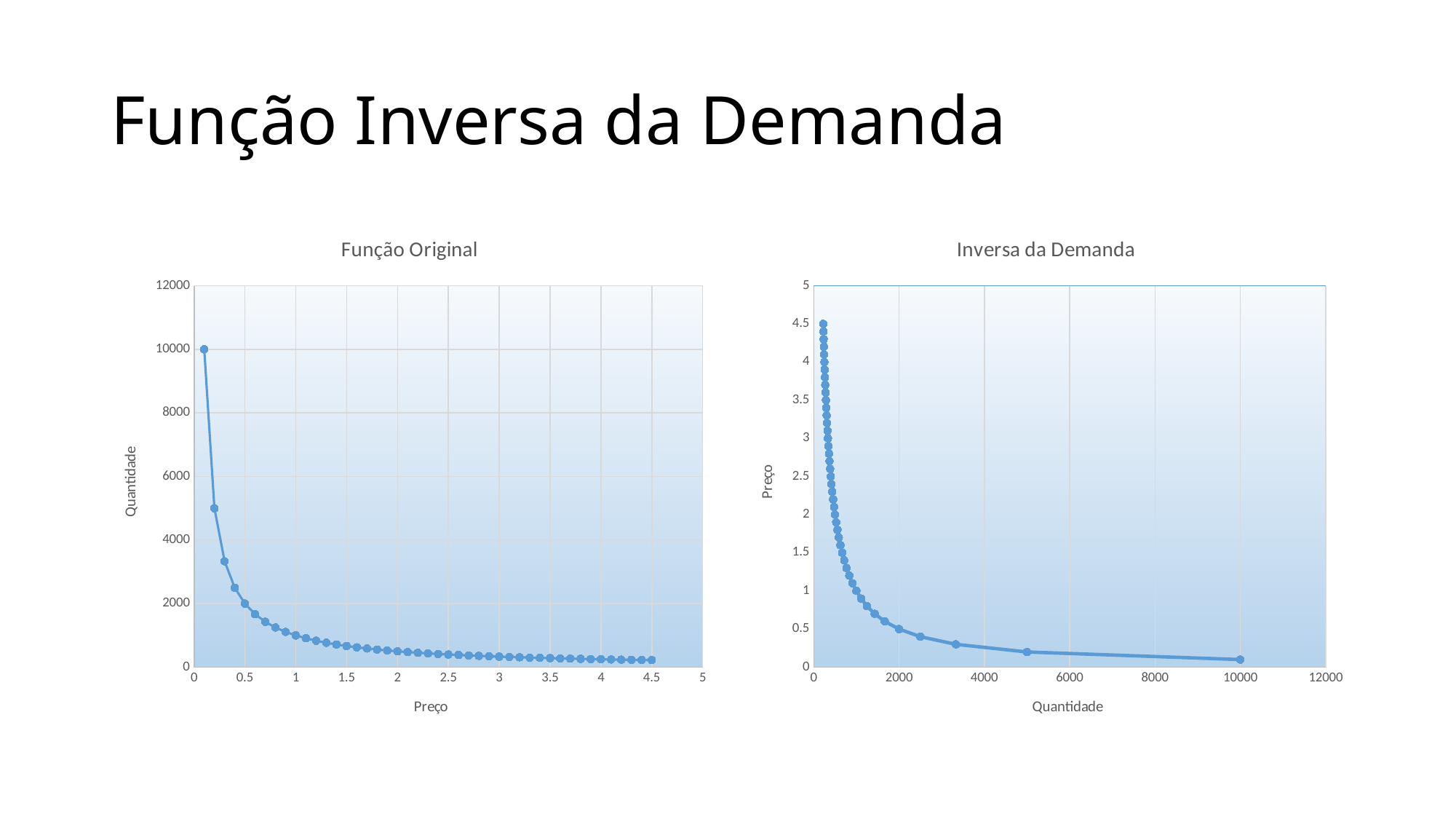
In the "Função Original" chart, which is larger: the Quantidade at Preço 0.5 or at Preço 2? Preço 0.5 What kind of chart is the "Função Original" chart? line chart In the "Função Original" chart, is the Quantidade at Preço 0.5 greater or less than 4000? less In the "Inversa da Demanda" chart, is the Preço at Quantidade 10000 greater or less than 0.5? less In the "Função Original" chart, do the values rise or fall as Preço increases? fall In the "Inversa da Demanda" chart, which is larger: the Preço at Quantidade 2000 or at Quantidade 10000? Quantidade 2000 In the "Função Original" chart, is the Quantidade at Preço 1 greater or less than 2000? less In the "Inversa da Demanda" chart, do the values rise or fall as Quantidade increases? fall What is the y-axis label of the "Inversa da Demanda" chart? Preço What is the x-axis label of the "Função Original" chart? Preço